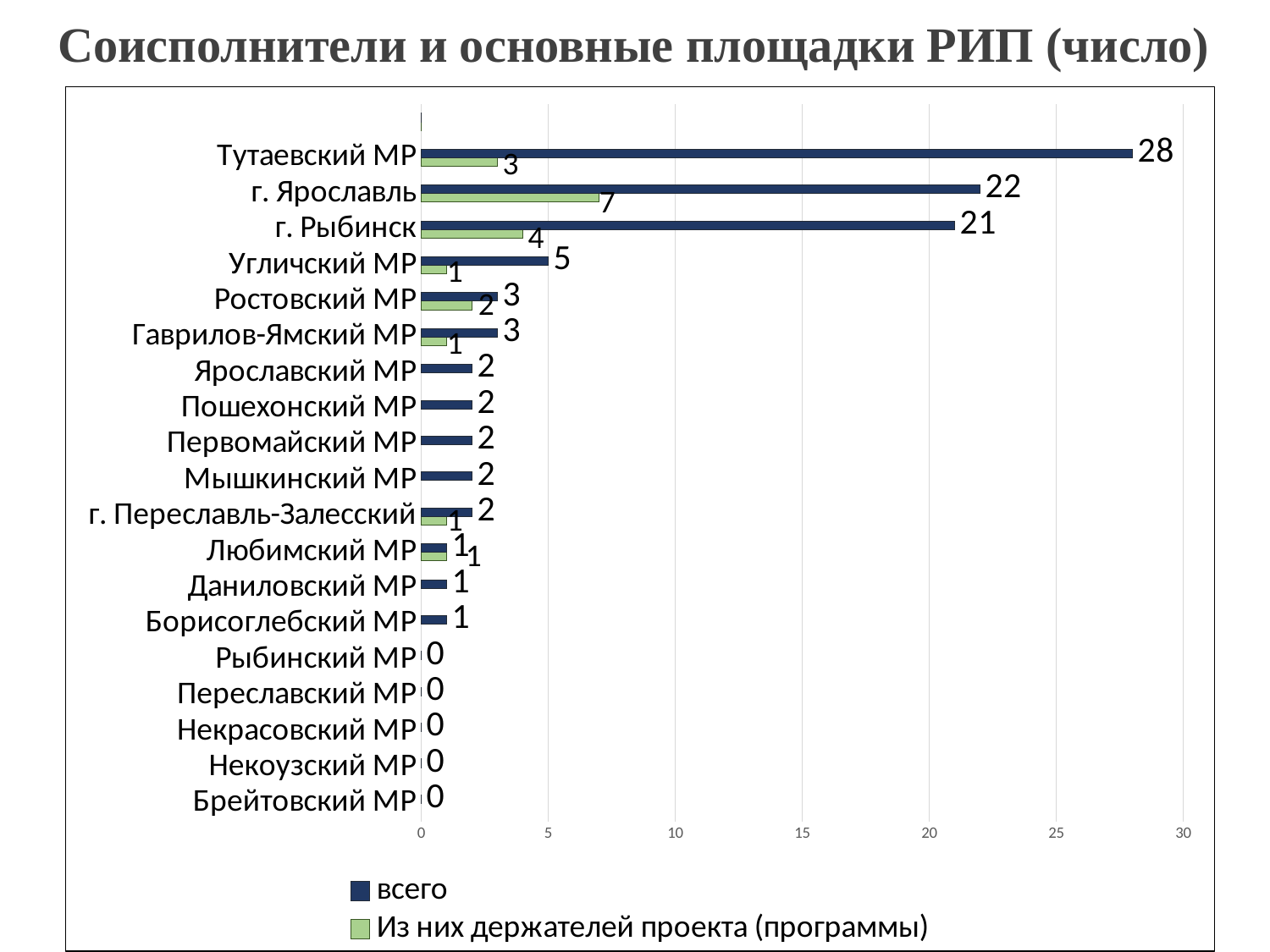
Which category has the highest 'Из них держателей проекта (программы)' value? г. Ярославль What is the 'Из них держателей проекта (программы)' value for г. Ярославль? 7 How many categories are shown on the vertical axis? 19 Is the 'всего' value for г. Рыбинск greater or less than 20? greater What is the title of the chart? Соисполнители и основные площадки РИП (число) What is the 'всего' value for Тутаевский МР? 28 What is the difference between the 'всего' values for Тутаевский МР and г. Ярославль? 6 Which category has the highest 'всего' value? Тутаевский МР What type of chart is shown on the slide? bar chart Which is larger, the 'всего' value for Угличский МР or for Ростовский МР? Угличский МР How many series does the legend list? 2 What is the 'всего' value for г. Рыбинск? 21